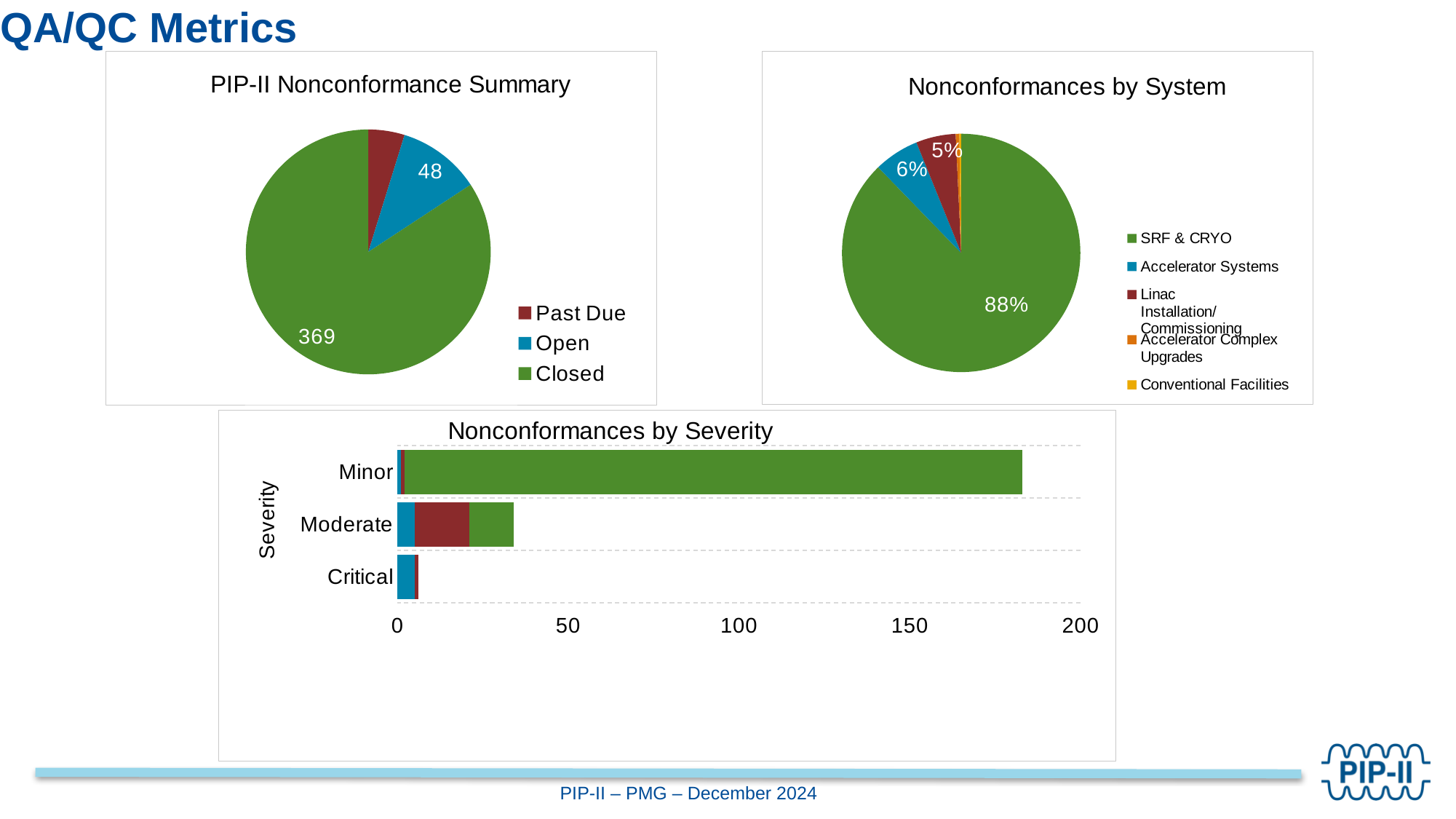
In the PIP-II Nonconformance Summary chart, how many nonconformances are Open? 48 In the PIP-II Nonconformance Summary chart, how many nonconformances are Closed? 369 In the Nonconformances by Severity chart, is the total for Moderate greater or less than 50? less In the PIP-II Nonconformance Summary chart, what is the difference between the Closed and Open counts? 321 What kind of chart is the PIP-II Nonconformance Summary? Pie chart In the Nonconformances by System chart, what share of nonconformances belongs to Accelerator Systems? 6% What kind of chart is Nonconformances by Severity? Bar chart How many systems are listed in the legend of the Nonconformances by System chart? 5 In the Nonconformances by Severity chart, which severity level has the longest bar? Minor In the Nonconformances by System chart, what share of nonconformances belongs to SRF & CRYO? 88% In the Nonconformances by System chart, what share of nonconformances belongs to Linac Installation/Commissioning? 5% In the PIP-II Nonconformance Summary chart, which category has the largest slice? Closed